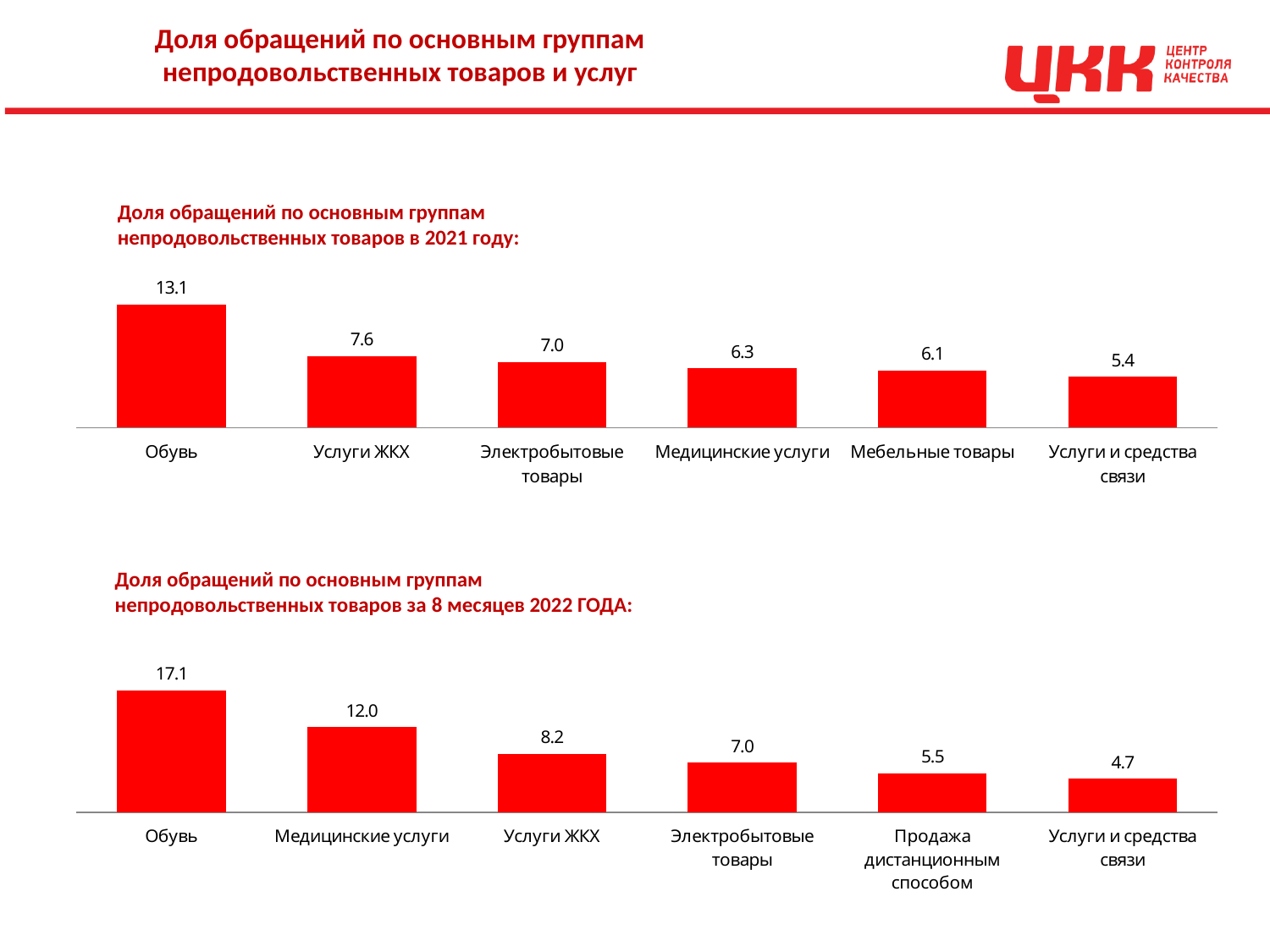
In the bottom chart (8 months of 2022), what is the difference between Медицинские услуги and Услуги ЖКХ? 3.8 In the bottom chart (8 months of 2022), what is the value for Медицинские услуги? 12.0 In the top chart (2021), which category has the highest value? Обувь In the top chart (2021), what is the value for Обувь? 13.1 In the top chart (2021), what is the difference between Обувь and Услуги ЖКХ? 5.5 How many categories are shown in the top chart (2021)? 6 In the bottom chart (8 months of 2022), which category has the lowest value? Услуги и средства связи In the bottom chart (8 months of 2022), what is the value for Продажа дистанционным способом? 5.5 In the top chart (2021), do the values rise or fall from left to right? Fall What type of chart is the bottom chart (8 months of 2022)? Bar chart In the top chart (2021), what is the value for Мебельные товары? 6.1 In the bottom chart (8 months of 2022), which is larger: Электробытовые товары or Продажа дистанционным способом? Электробытовые товары